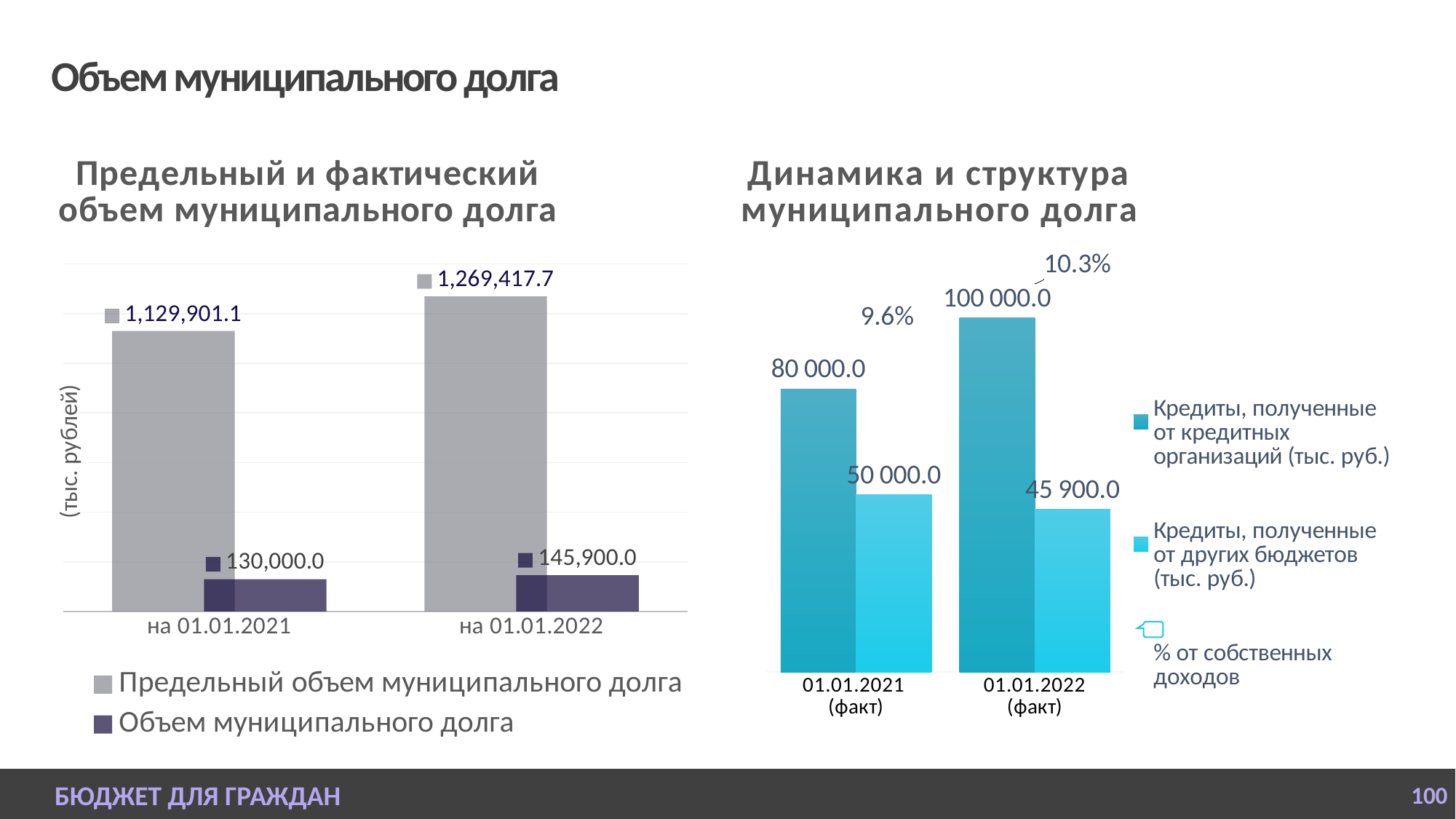
In the chart 'Предельный и фактический объем муниципального долга', what is the value of 'Объем муниципального долга' for 'на 01.01.2022'? 145,900.0 In the chart 'Предельный и фактический объем муниципального долга', what is the value of 'Предельный объем муниципального долга' for 'на 01.01.2021'? 1,129,901.1 In the chart 'Динамика и структура муниципального долга', what is the '% от собственных доходов' value for 01.01.2022 (факт)? 10.3% In the chart 'Динамика и структура муниципального долга', what is the difference between 'Кредиты, полученные от других бюджетов' on 01.01.2021 and on 01.01.2022? 4 100.0 In the chart 'Динамика и структура муниципального долга', what is the value of 'Кредиты, полученные от других бюджетов' for 01.01.2021 (факт)? 50 000.0 How many series does the legend of the chart 'Динамика и структура муниципального долга' list? 3 In the chart 'Динамика и структура муниципального долга', which is larger for 01.01.2021 (факт): 'Кредиты, полученные от кредитных организаций' or 'Кредиты, полученные от других бюджетов'? Кредиты, полученные от кредитных организаций In the chart 'Предельный и фактический объем муниципального долга', does 'Объем муниципального долга' rise or fall from 01.01.2021 to 01.01.2022? rise In the chart 'Предельный и фактический объем муниципального долга', what is the difference between 'Предельный объем муниципального долга' on 01.01.2022 and on 01.01.2021? 139,516.6 What type of chart is 'Предельный и фактический объем муниципального долга'? bar chart In the chart 'Динамика и структура муниципального долга', what is the value of 'Кредиты, полученные от кредитных организаций' for 01.01.2022 (факт)? 100 000.0 How many series does the legend of the chart 'Предельный и фактический объем муниципального долга' list? 2